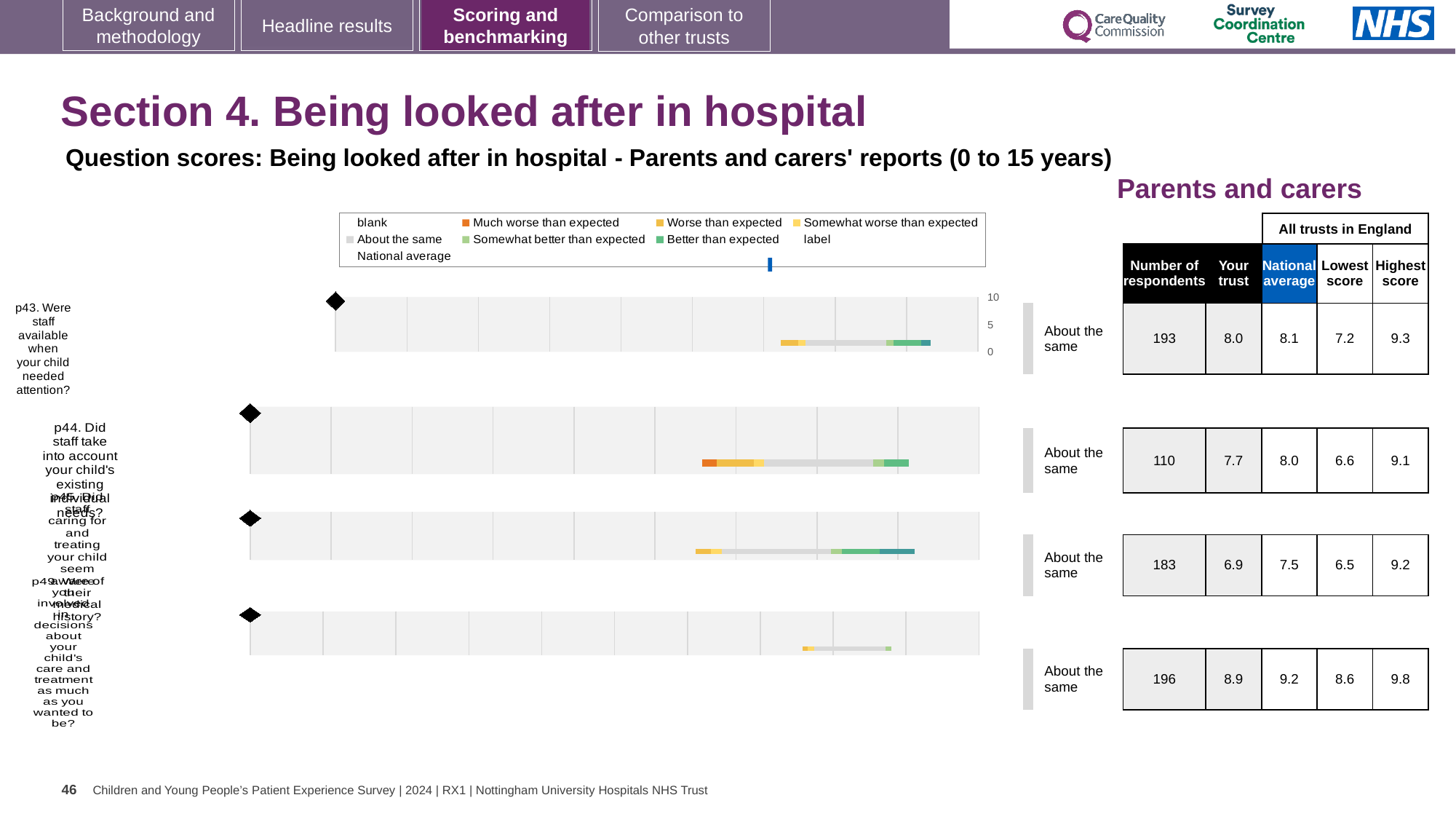
How many respondents are shown for p43 (Were staff available when your child needed attention?)? 193 What is the highest score among all trusts in England for p49? 9.8 What is the lowest score among all trusts in England for p45? 6.5 For p45, what is the difference between the national average and the 'Your trust' score? 0.6 What kind of chart is used to show the question scores? Bar chart What benchmark category is shown for each of the four questions? About the same Which question has the highest 'Your trust' score? p49 What is the national average score for p44 (Did staff take into account your child's existing individual needs?)? 8.0 Which has the larger 'Your trust' score, p43 or p44? p43 Which question has the lowest 'Your trust' score? p45 How many questions are plotted on the slide? 4 What is the 'Your trust' score for p43 (Were staff available when your child needed attention?)? 8.0